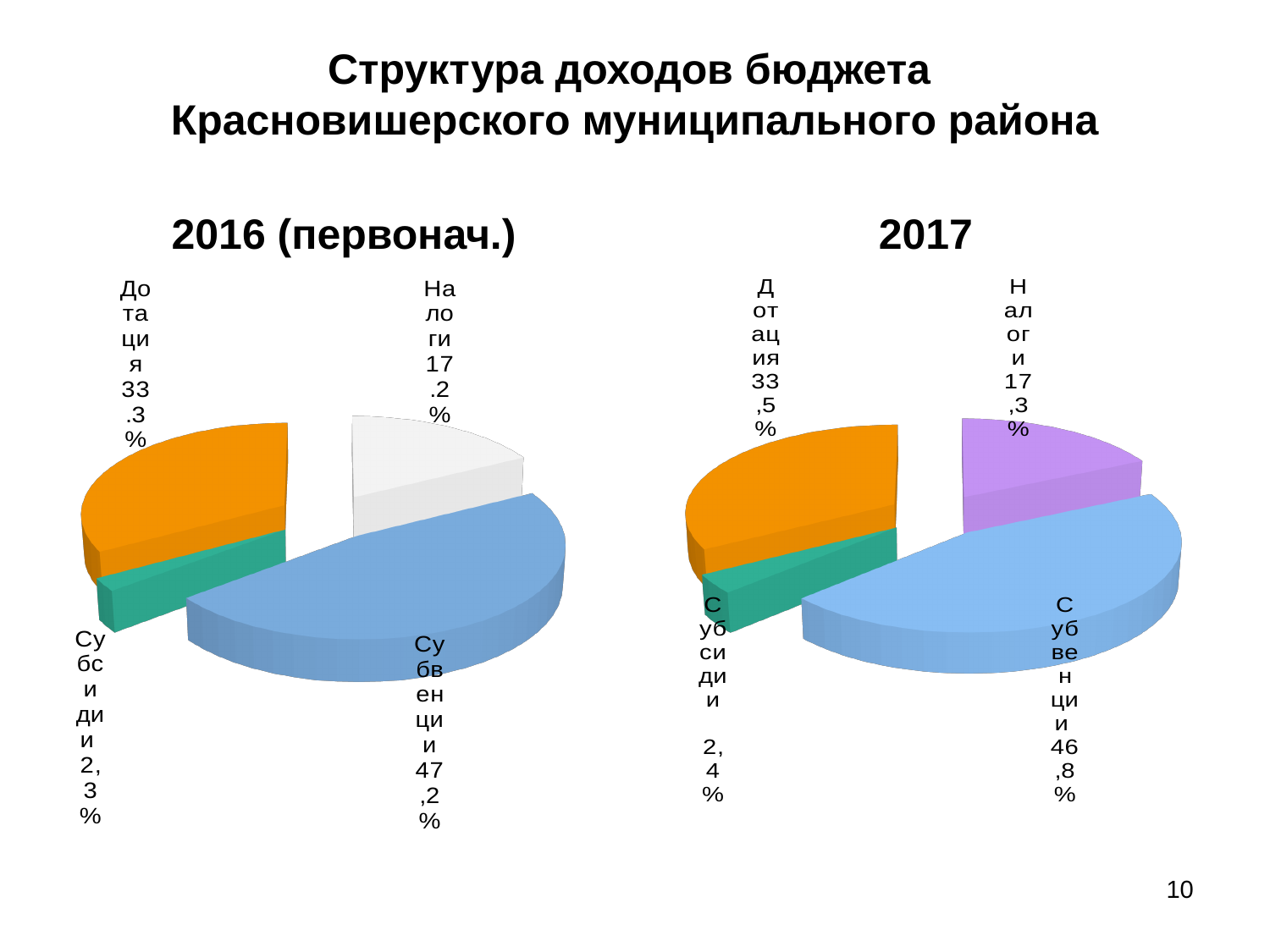
In the 2016 (первонач.) chart, which is larger: Дотация or Налоги? Дотация In the 2016 (первонач.) chart, what is the combined share of Дотация and Налоги? 50.5% In the 2017 chart, what is the difference between the Субвенции share and the Дотация share? 13,3% How many slices does the 2017 chart have? 4 In the 2017 chart, what share is labelled for Субсидии? 2,4% In the 2017 chart, what share is labelled for Налоги? 17,3% In the 2016 (первонач.) chart, what share is labelled for Субвенции? 47,2% In the 2016 (первонач.) chart, which category has the smallest slice? Субсидии In the 2017 chart, which category has the largest slice? Субвенции In the 2016 (первонач.) chart, what share is labelled for Дотация? 33.3% What type of chart is used for 2016 (первонач.)? Pie chart What is the title of the slide? Структура доходов бюджета Красновишерского муниципального района